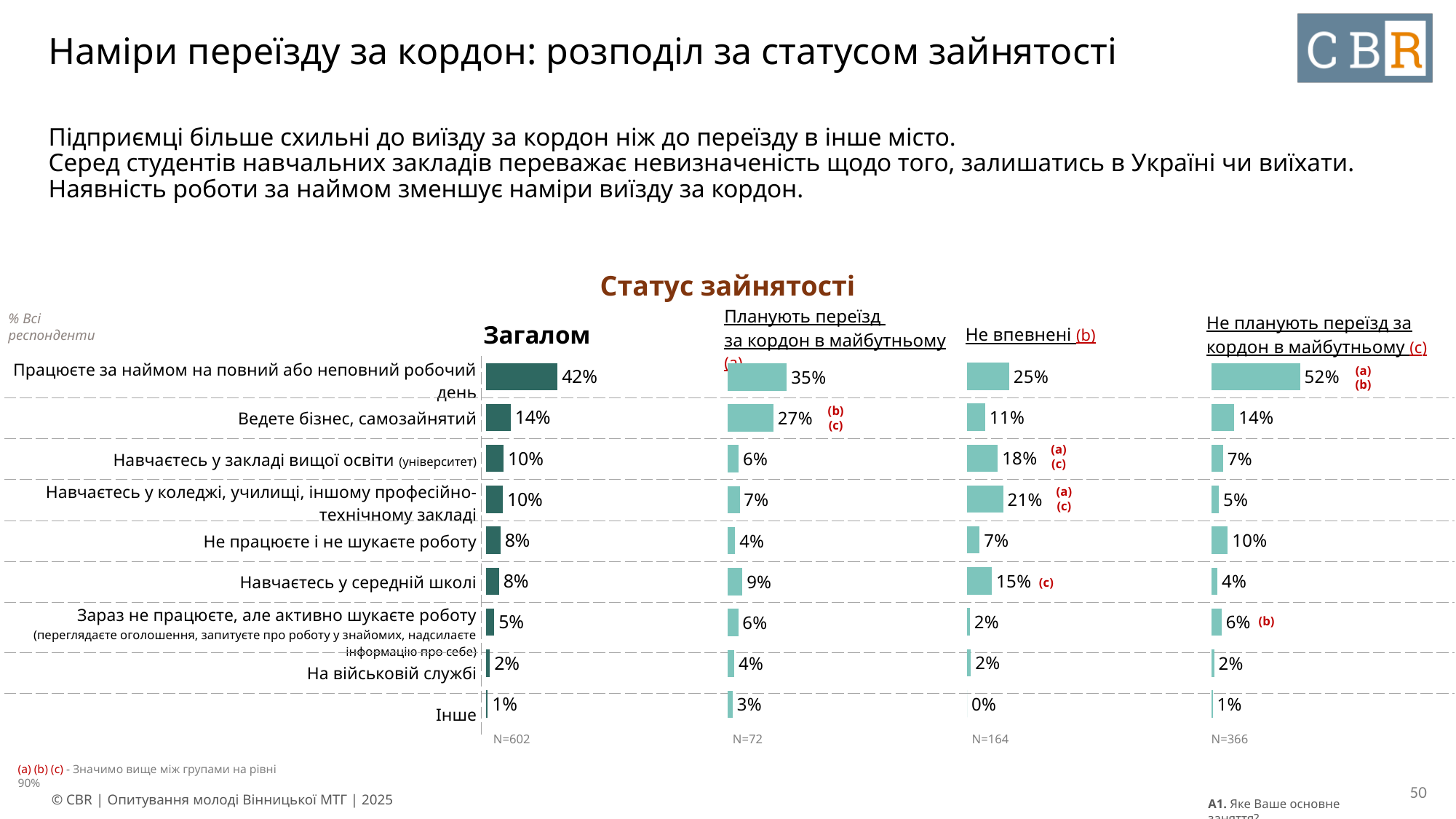
Which is larger: the value for "Навчаєтесь у закладі вищої освіти" in the "Не впевнені" chart or in the "Планують переїзд за кордон в майбутньому" chart? Не впевнені What is the sample size (N) shown under the "Не впевнені" chart? N=164 In the "Загалом" chart, what is the value for "Працюєте за наймом на повний або неповний робочий день"? 42% In the "Не впевнені" chart, what is the difference between "Навчаєтесь у середній школі" and "Не працюєте і не шукаєте роботу"? 8% What kind of chart is used on this slide? Bar chart How many categories are shown in the "Загалом" chart? 9 In the "Не планують переїзд за кордон в майбутньому" chart, which category has the highest value? Працюєте за наймом на повний або неповний робочий день In the "Загалом" chart, what is the difference between "Працюєте за наймом на повний або неповний робочий день" and "Ведете бізнес, самозайнятий"? 28% In the "Не планують переїзд за кордон в майбутньому" chart, what is the value for "Не працюєте і не шукаєте роботу"? 10% In the "Планують переїзд за кордон в майбутньому" chart, what is the value for "Ведете бізнес, самозайнятий"? 27% In the "Не впевнені" chart, what is the value for "Навчаєтесь у коледжі, училищі, іншому професійно-технічному закладі"? 21% In the "Не впевнені" chart, which category has the lowest value? Інше